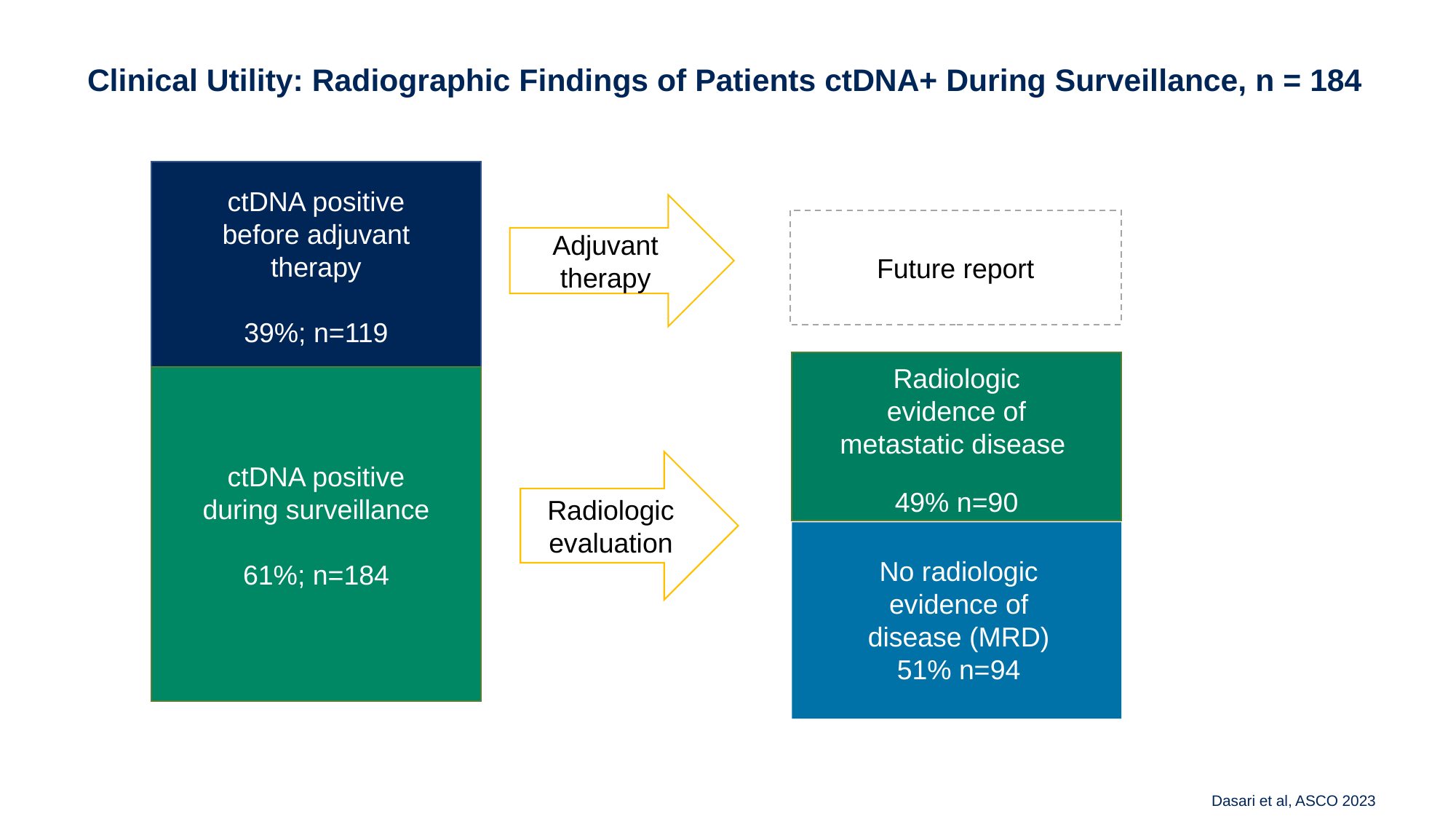
What percentage of patients were ctDNA positive during surveillance? 61% What is shown in the dashed box that the Adjuvant therapy arrow points to? Future report How many patients were ctDNA positive before adjuvant therapy? n=119 What percentage of the surveillance ctDNA+ patients had radiologic evidence of metastatic disease? 49% How many patients had no radiologic evidence of disease (MRD)? n=94 How many patients were ctDNA positive during surveillance? n=184 What is the difference in patient numbers between the no radiologic evidence of disease group and the radiologic evidence of metastatic disease group? 4 What does the arrow from the ctDNA positive during surveillance box lead to? The two radiologic outcome boxes: Radiologic evidence of metastatic disease (49% n=90) and No radiologic evidence of disease (MRD) (51% n=94) Which group is larger: ctDNA positive before adjuvant therapy or ctDNA positive during surveillance? ctDNA positive during surveillance What percentage of patients were ctDNA positive before adjuvant therapy? 39% What is the total number of patients in the two left-hand ctDNA positive boxes combined? 303 Which radiologic outcome group is larger: radiologic evidence of metastatic disease or no radiologic evidence of disease (MRD)? No radiologic evidence of disease (MRD)